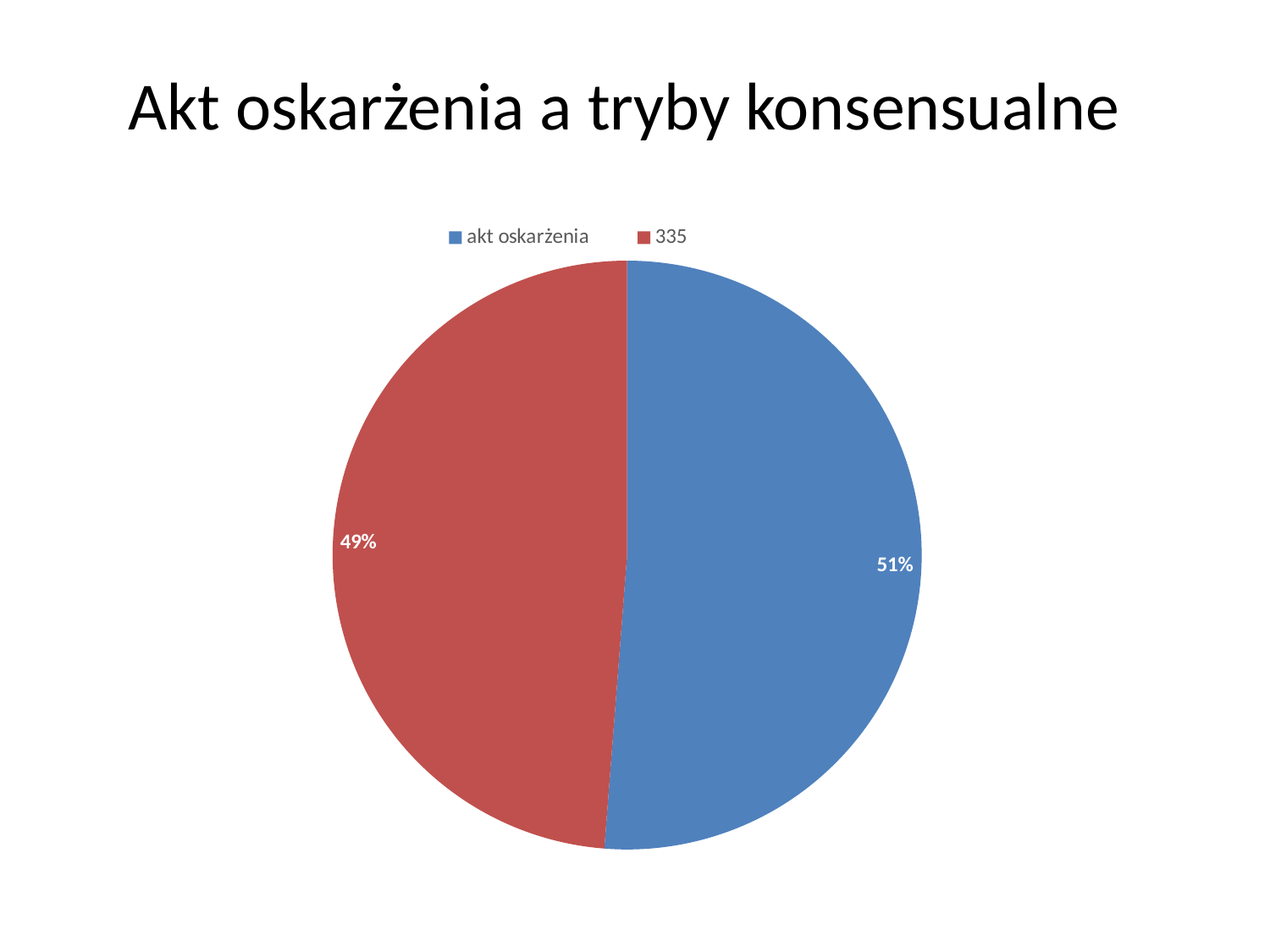
What share of the pie does the "akt oskarżenia" slice represent? 51% Which slice is the largest in the pie chart? akt oskarżenia What is the title of the slide? Akt oskarżenia a tryby konsensualne How many entries does the legend list? 2 What share of the pie does the "335" slice represent? 49% Which slice is the smallest in the pie chart? 335 What colour is the "akt oskarżenia" slice? blue How many slices does the pie chart have? 2 Which slice is larger, "akt oskarżenia" or "335"? akt oskarżenia What kind of chart is shown on the slide? pie chart What is the difference in percentage points between the "akt oskarżenia" slice and the "335" slice? 2 percentage points